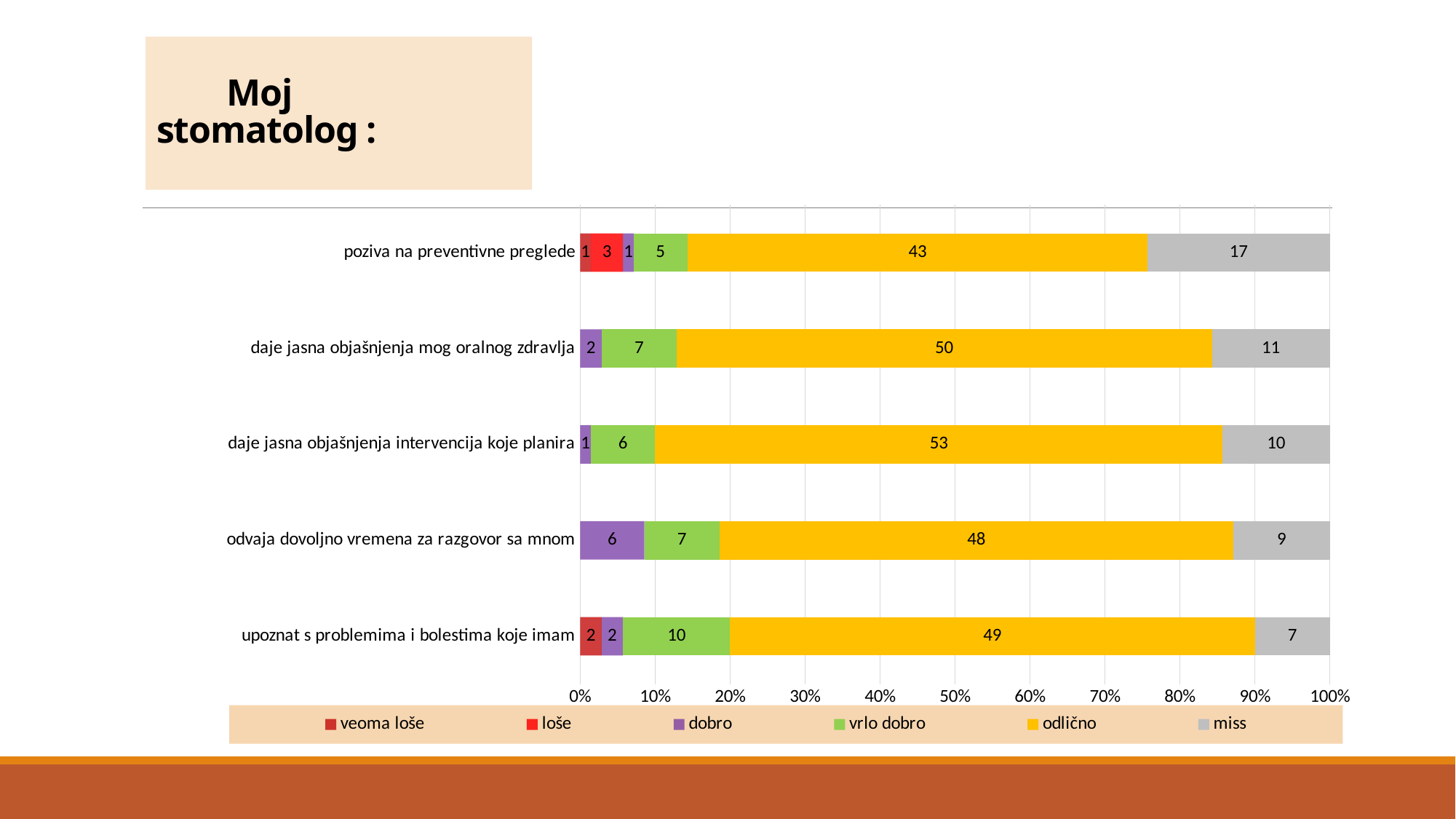
Which is larger: the 'vrlo dobro' value for 'odvaja dovoljno vremena za razgovor sa mnom' or for 'daje jasna objašnjenja intervencija koje planira'? odvaja dovoljno vremena za razgovor sa mnom What is the 'dobro' value for 'odvaja dovoljno vremena za razgovor sa mnom'? 6 Which category has the lowest 'miss' value? upoznat s problemima i bolestima koje imam How many categories are shown on the chart? 5 What is the 'odlično' value for 'daje jasna objašnjenja intervencija koje planira'? 53 What is the difference between the 'odlično' values for 'daje jasna objašnjenja mog oralnog zdravlja' and 'poziva na preventivne preglede'? 7 Which category has the highest 'odlično' value? daje jasna objašnjenja intervencija koje planira What is the total of all segments in the bar for 'odvaja dovoljno vremena za razgovor sa mnom'? 70 What kind of chart is shown on the slide? stacked bar chart What is the 'miss' value for 'poziva na preventivne preglede'? 17 What is the 'vrlo dobro' value for 'upoznat s problemima i bolestima koje imam'? 10 How many series does the legend list? 6